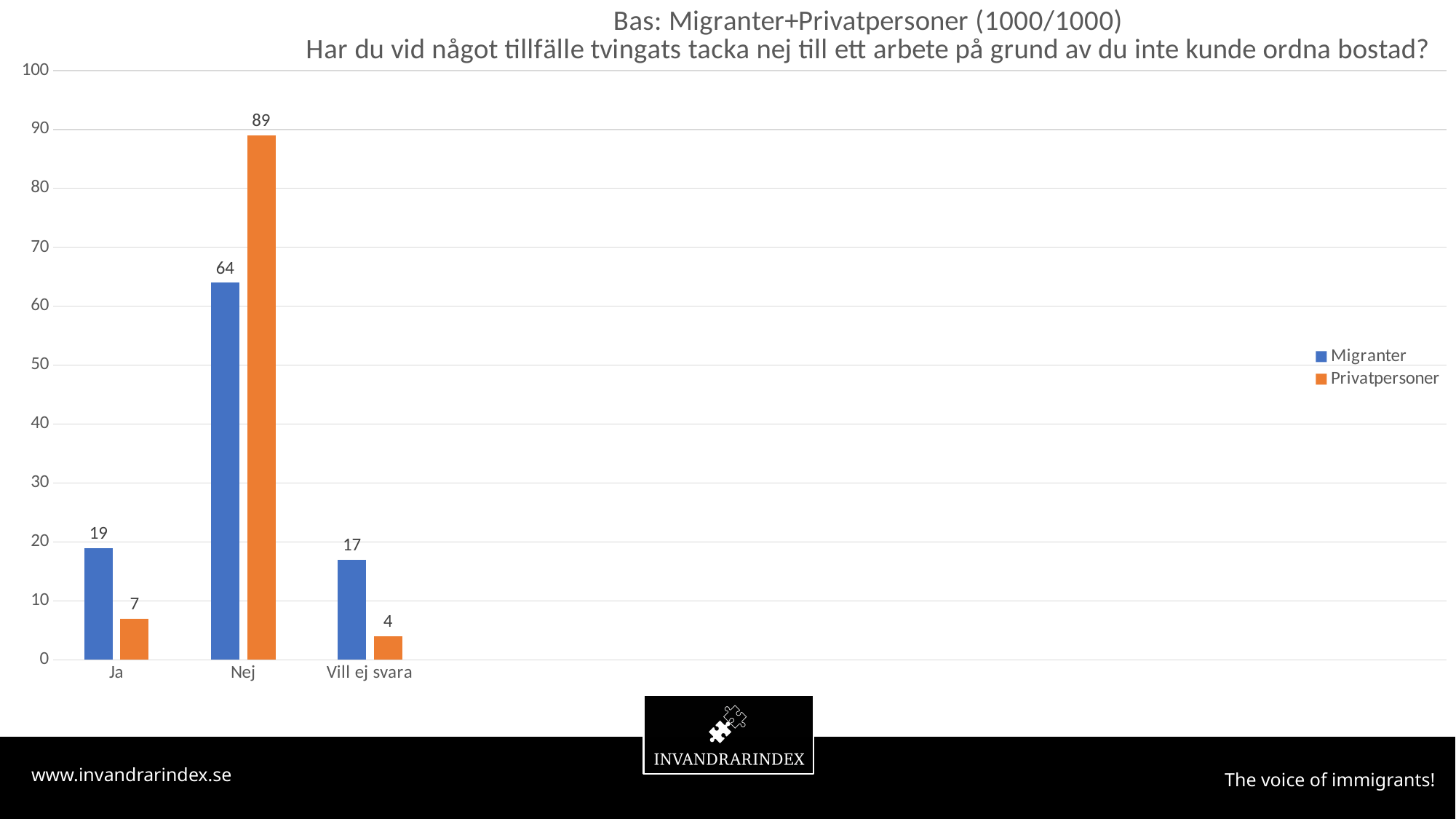
What is the value for Privatpersoner in the Nej category? 89 Which category has the highest value for Migranter? Nej Is the value for Migranter in the Nej category greater or less than 50? greater Which colour represents the Privatpersoner series? Orange How many series does the legend list? 2 Which category has the lowest value for Privatpersoner? Vill ej svara What is the value for Migranter in the Ja category? 19 What is the value for Privatpersoner in the Vill ej svara category? 4 How many categories are shown on the x axis? 3 Which is larger in the Ja category, Migranter or Privatpersoner? Migranter What kind of chart is shown on the slide? Bar chart What is the difference between the Privatpersoner and Migranter values in the Nej category? 25